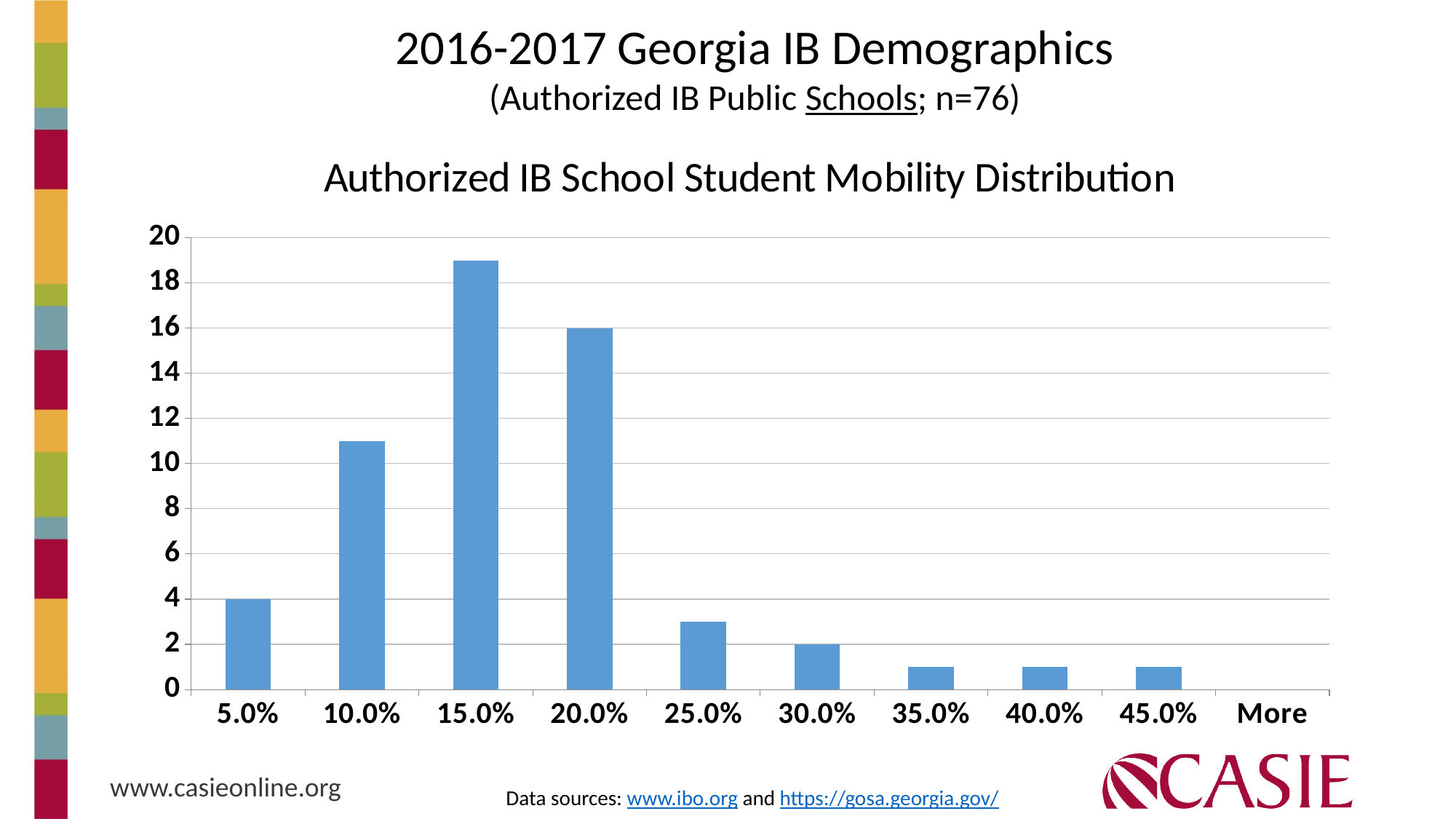
Is the value for 15.0% greater or less than 18? greater What is the difference between the value for 20.0% and the value for 5.0%? 12 What type of chart is shown on the slide? bar chart How many categories are shown on the x axis? 10 What is the title of the chart? Authorized IB School Student Mobility Distribution What is the value for the 5.0% category? 4 Which category has the lowest bar? More What is the value for the 30.0% category? 2 Is the value for 10.0% greater or less than 10? greater Which is larger, the value for 15.0% or the value for 20.0%? 15.0% What is the value for the 20.0% category? 16 Which category has the highest bar? 15.0%